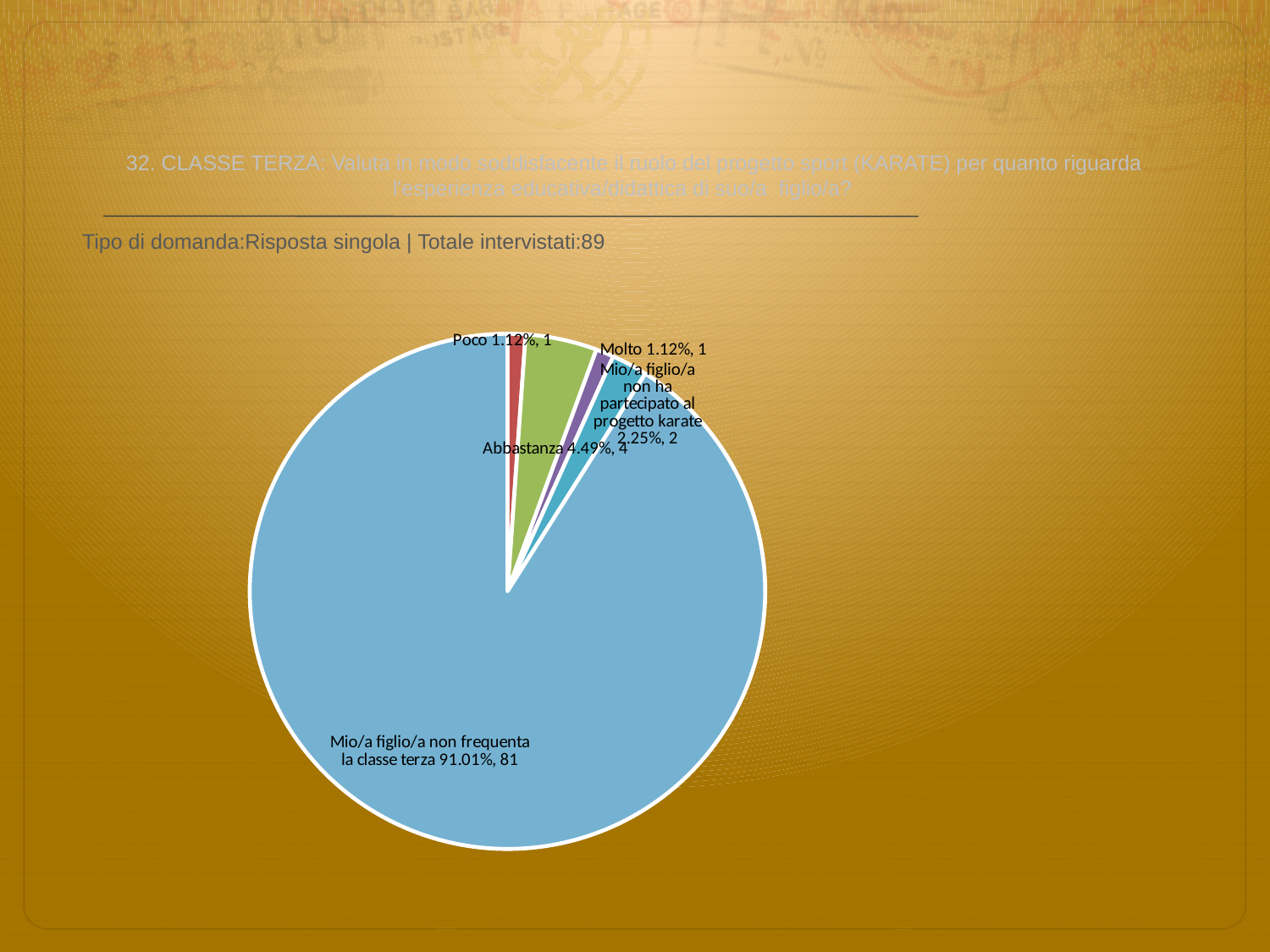
How many respondents are in the "Abbastanza" slice? 4 Which slice is the largest in the pie chart? Mio/a figlio/a non frequenta la classe terza What kind of chart is shown on the slide? Pie chart Which slice is larger, "Abbastanza" or "Molto"? Abbastanza What percentage share does the slice "Mio/a figlio/a non ha partecipato al progetto karate" have? 2.25% What percentage share does the slice "Mio/a figlio/a non frequenta la classe terza" have? 91.01% What is the total number of respondents (Totale intervistati) stated on the slide? 89 What is the difference in respondent count between "Abbastanza" and "Mio/a figlio/a non ha partecipato al progetto karate"? 2 How many respondents answered "Poco"? 1 How many slices does the pie chart have? 5 How many respondents are in the "Mio/a figlio/a non frequenta la classe terza" slice? 81 What percentage share does the slice "Abbastanza" have? 4.49%